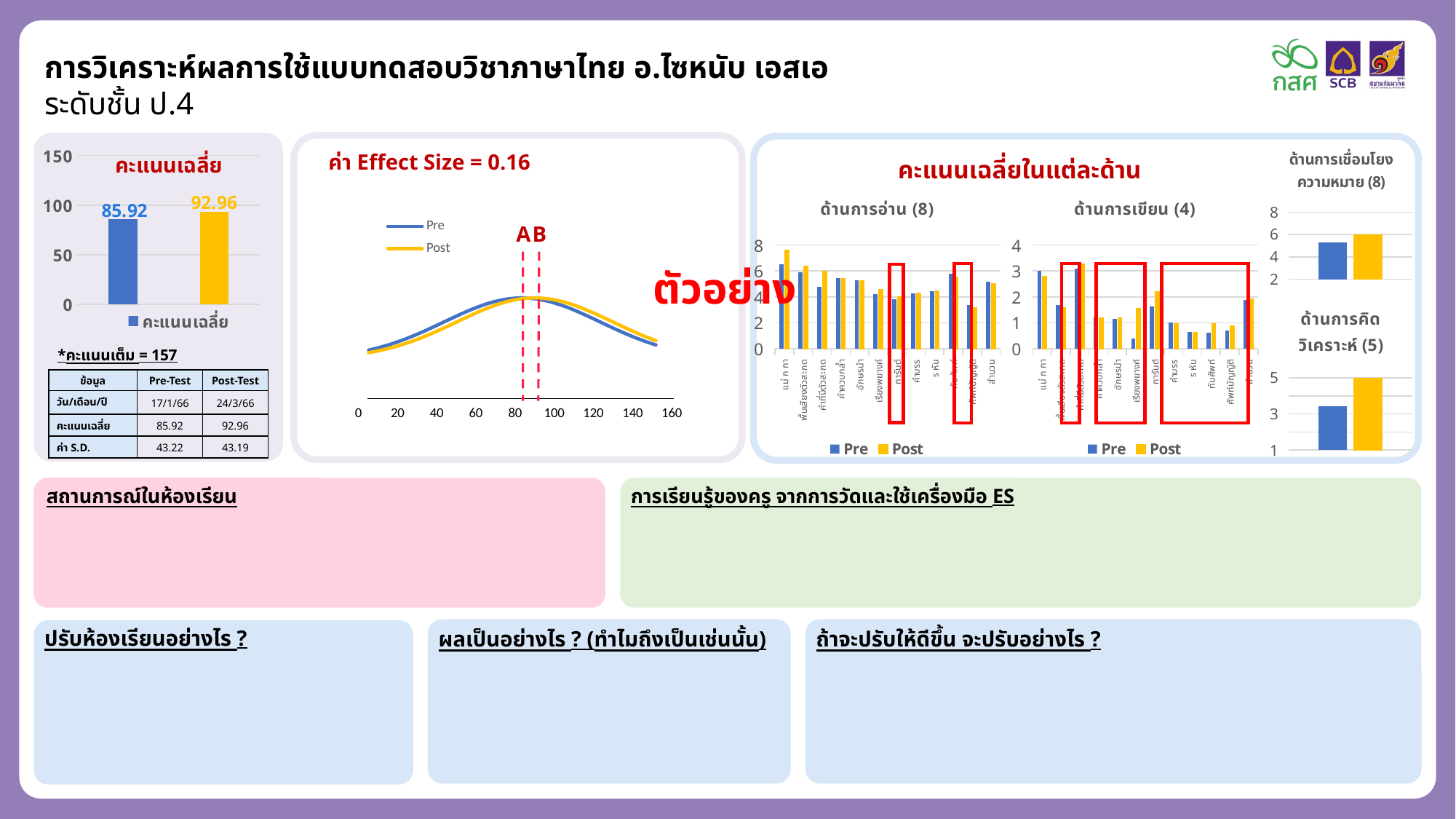
In the left chart titled คะแนนเฉลี่ย, what is the value of the blue bar? 85.92 How many series does the legend of the chart titled ด้านการอ่าน (8) list? 2 In the middle Effect Size chart, what is the highest value shown on the x axis? 160 In the left chart titled คะแนนเฉลี่ย, is the value of the blue bar greater or less than 50? greater In the left chart titled คะแนนเฉลี่ย, what is the difference between the yellow bar and the blue bar? 7.04 In the left chart titled คะแนนเฉลี่ย, what is the value of the yellow bar? 92.96 In the chart titled ด้านการคิดวิเคราะห์ (5), which bar is higher, Pre or Post? Post In the chart titled ด้านการเชื่อมโยงความหมาย (8), what is the value of the Post bar? 6 What kind of chart is the middle chart labelled ค่า Effect Size = 0.16? line chart How many series does the legend of the middle Effect Size chart list? 2 In the left chart titled คะแนนเฉลี่ย, which bar is higher, the blue one or the yellow one? the yellow one What kind of chart is the left chart titled คะแนนเฉลี่ย? bar chart